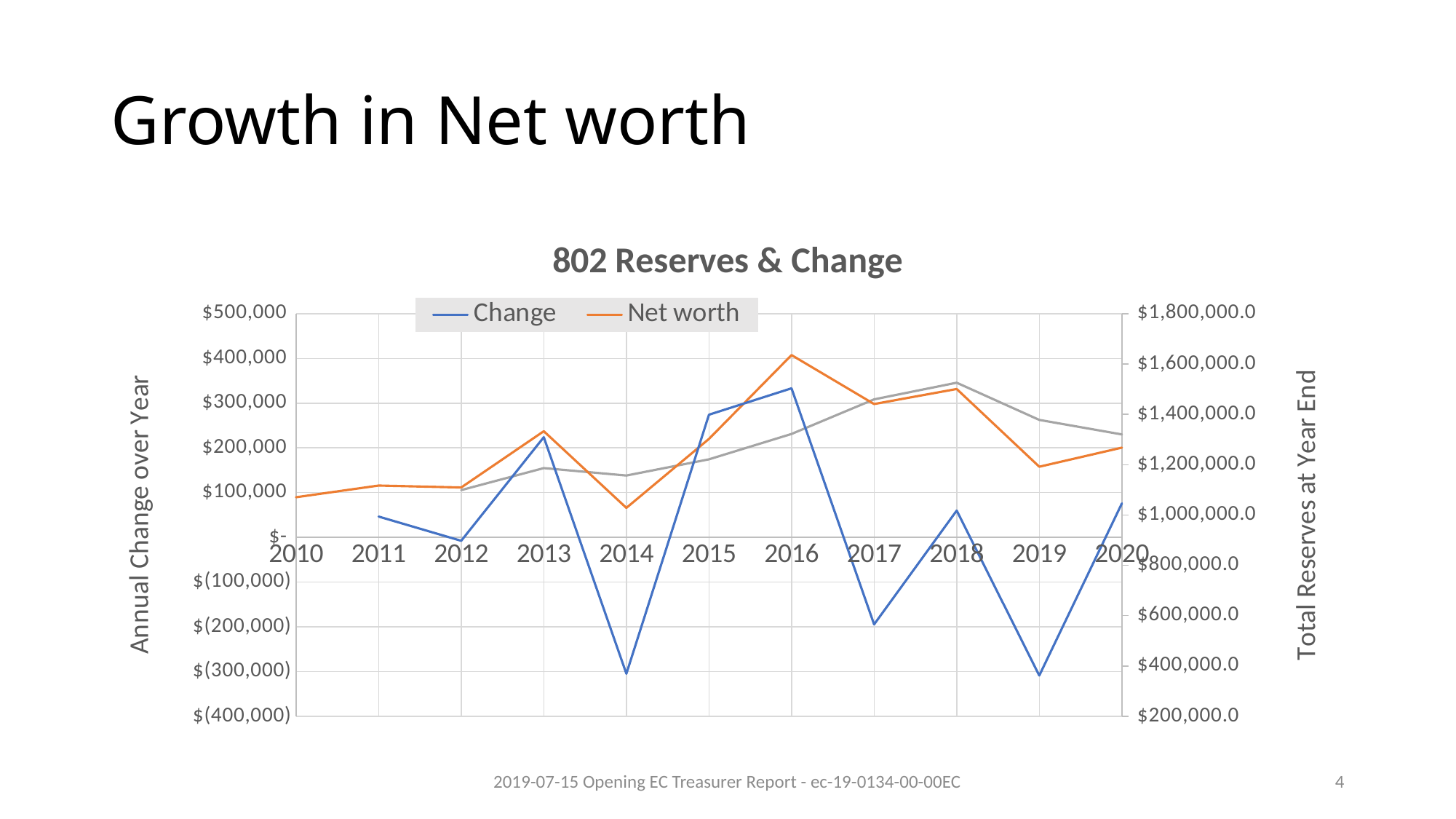
What is the title of the chart? 802 Reserves & Change In which year does the Change series reach its highest value? 2016 How many series does the chart legend list? 2 Is the Net worth value for 2019 greater or less than $1,400,000.0? less In which year does the Net worth series reach its highest value? 2016 Is the Change value for 2016 greater or less than $300,000? greater Is the Net worth value for 2016 greater or less than $1,400,000.0? greater Does the Net worth series rise or fall from 2014 to 2016? Rise What kind of chart is shown on the slide? Line chart How many years are shown on the x axis of the chart? 11 Which year has the larger Net worth value, 2013 or 2014? 2013